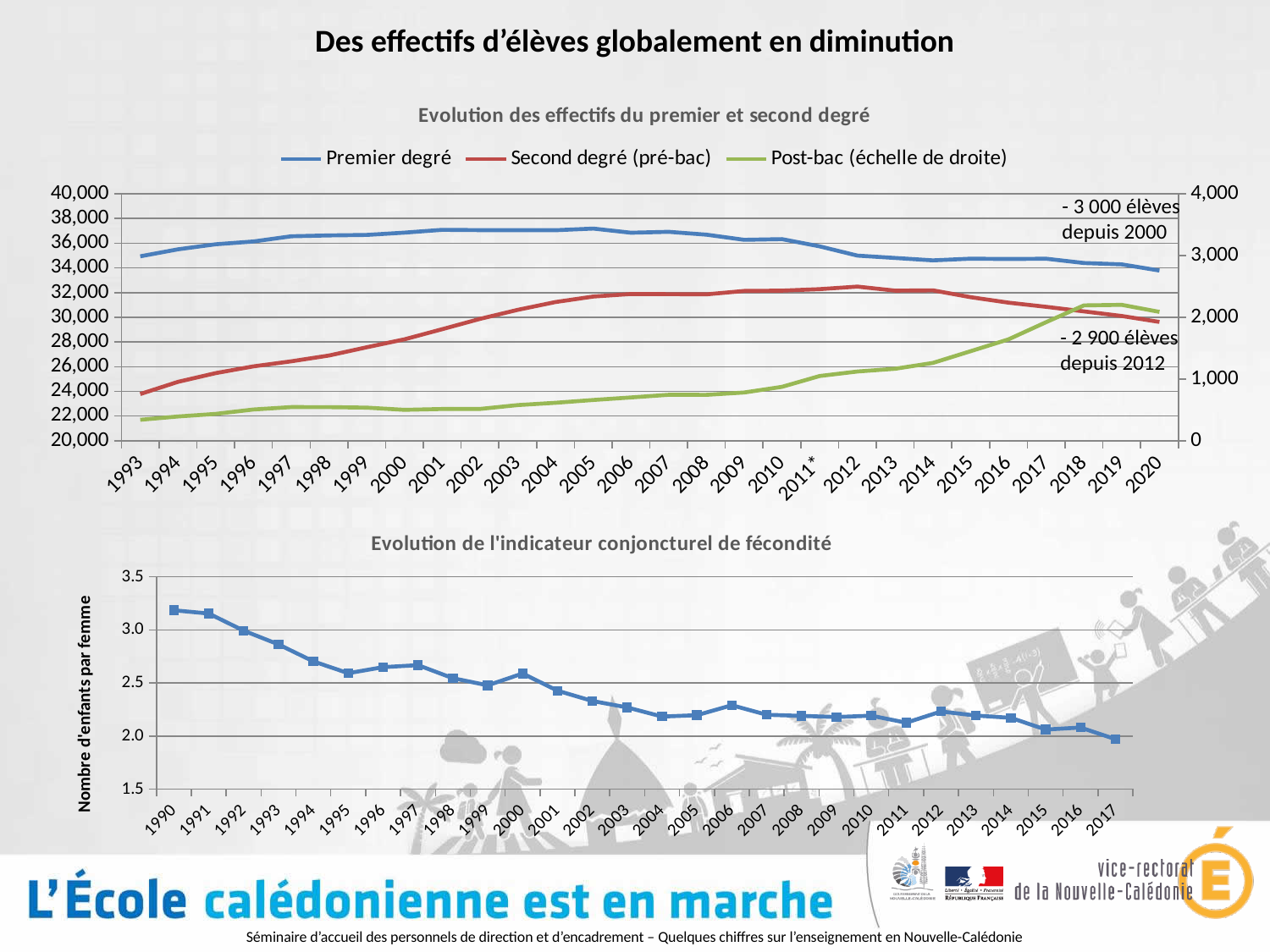
In the bottom chart, is the value for 1990 greater or less than 3.0? greater In the top chart, is the value for Second degré (pré-bac) in 2012 greater or less than 30,000? greater What is the title of the bottom chart? Evolution de l'indicateur conjoncturel de fécondité How many series does the legend of the top chart list? 3 How many years are shown on the x axis of the top chart? 28 In the top chart, is the value for Second degré (pré-bac) in 1993 greater or less than 26,000? less In the top chart, which is larger in 2005: Premier degré or Second degré (pré-bac)? Premier degré What type of chart is the top chart, 'Evolution des effectifs du premier et second degré'? line chart In the bottom chart, do the values generally rise or fall from 1990 to 2017? fall In the top chart, which series is plotted on the right-hand axis according to the legend? Post-bac (échelle de droite)